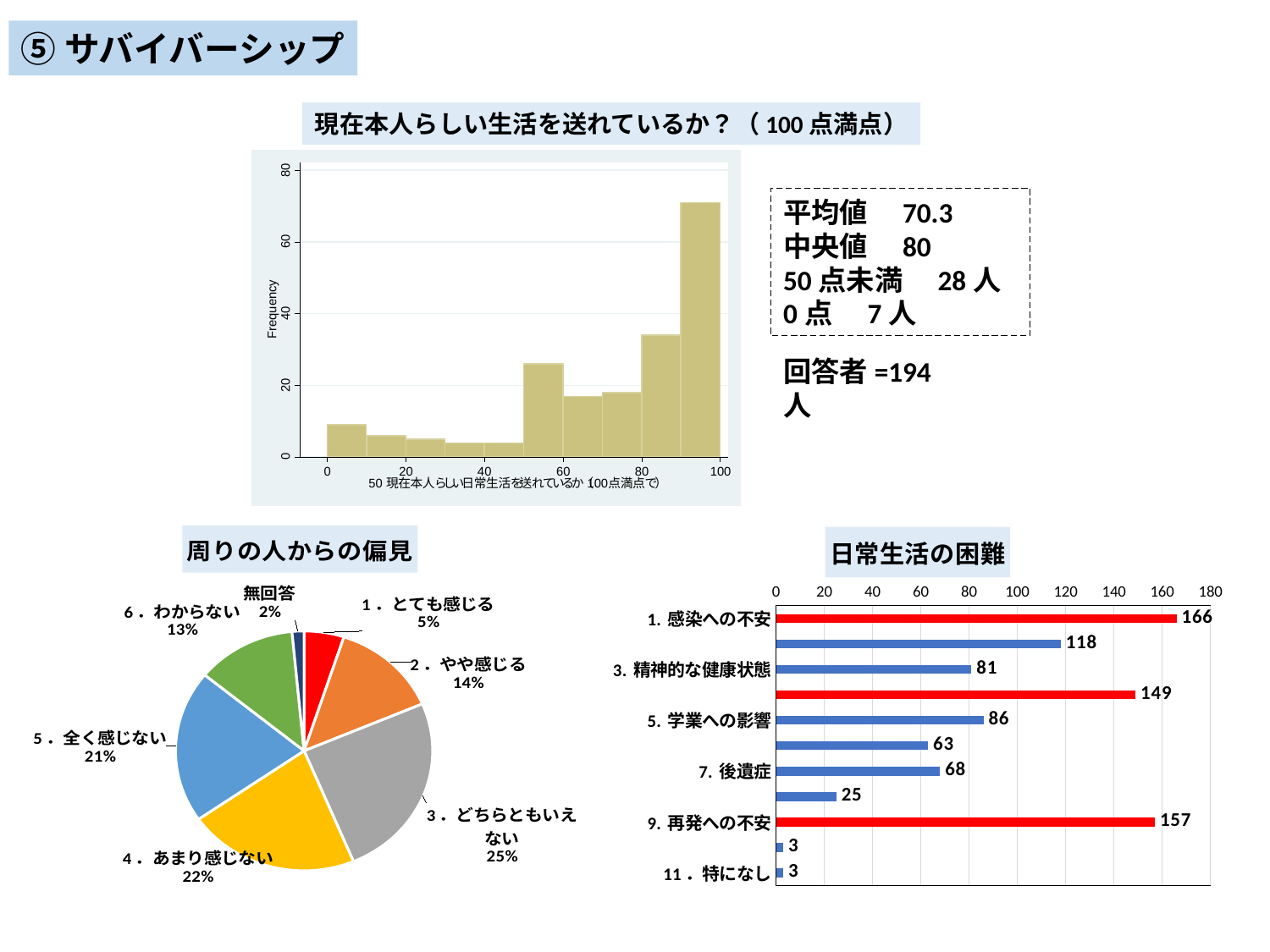
In the 日常生活の困難 chart, what is the value for 7. 後遺症? 68 In the 周りの人からの偏見 pie chart, what share does 3. どちらともいえない have? 25% In the 日常生活の困難 chart, what is the value for 11. 特になし? 3 In the 周りの人からの偏見 pie chart, which slice is the smallest? 無回答 In the 周りの人からの偏見 pie chart, what share does 5. 全く感じない have? 21% In the top histogram, is the frequency of the 90–100 bar greater or less than 60? greater How many slices does the 周りの人からの偏見 pie chart have? 7 In the 日常生活の困難 chart, what is the value for 9. 再発への不安? 157 In the 日常生活の困難 chart, which is larger, 5. 学業への影響 or 3. 精神的な健康状態? 5. 学業への影響 In the 日常生活の困難 chart, what is the difference between 1. 感染への不安 and 9. 再発への不安? 9 In the 日常生活の困難 chart, what is the value for 1. 感染への不安? 166 In the 日常生活の困難 chart, which labeled category has the highest value? 1. 感染への不安